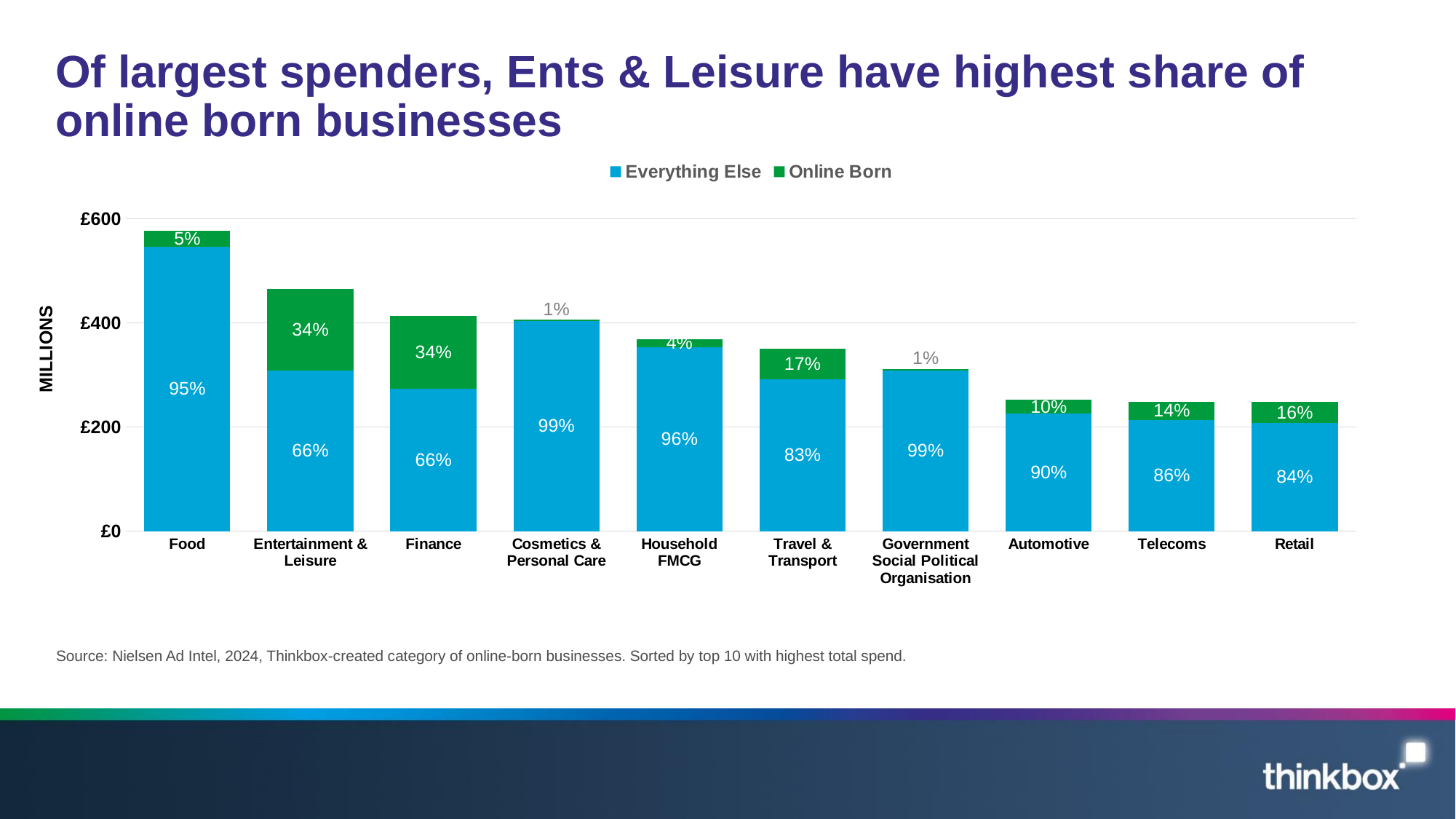
Is the total bar for Automotive greater or less than £400 million? less What is the Everything Else percentage label shown for Food? 95% Is the total bar for Entertainment & Leisure greater or less than £400 million? greater Which has the larger Online Born percentage label, Travel & Transport or Telecoms? Travel & Transport How many categories are shown on the x axis? 10 What is the Online Born percentage label shown for Retail? 16% What kind of chart is shown on the slide? Stacked bar chart What is the Everything Else percentage label shown for Travel & Transport? 83% What is the Online Born percentage label shown for Entertainment & Leisure? 34% How many series does the legend list? 2 Which category has the tallest bar (highest total spend)? Food Do the total bar heights rise or fall from left to right across the categories? fall